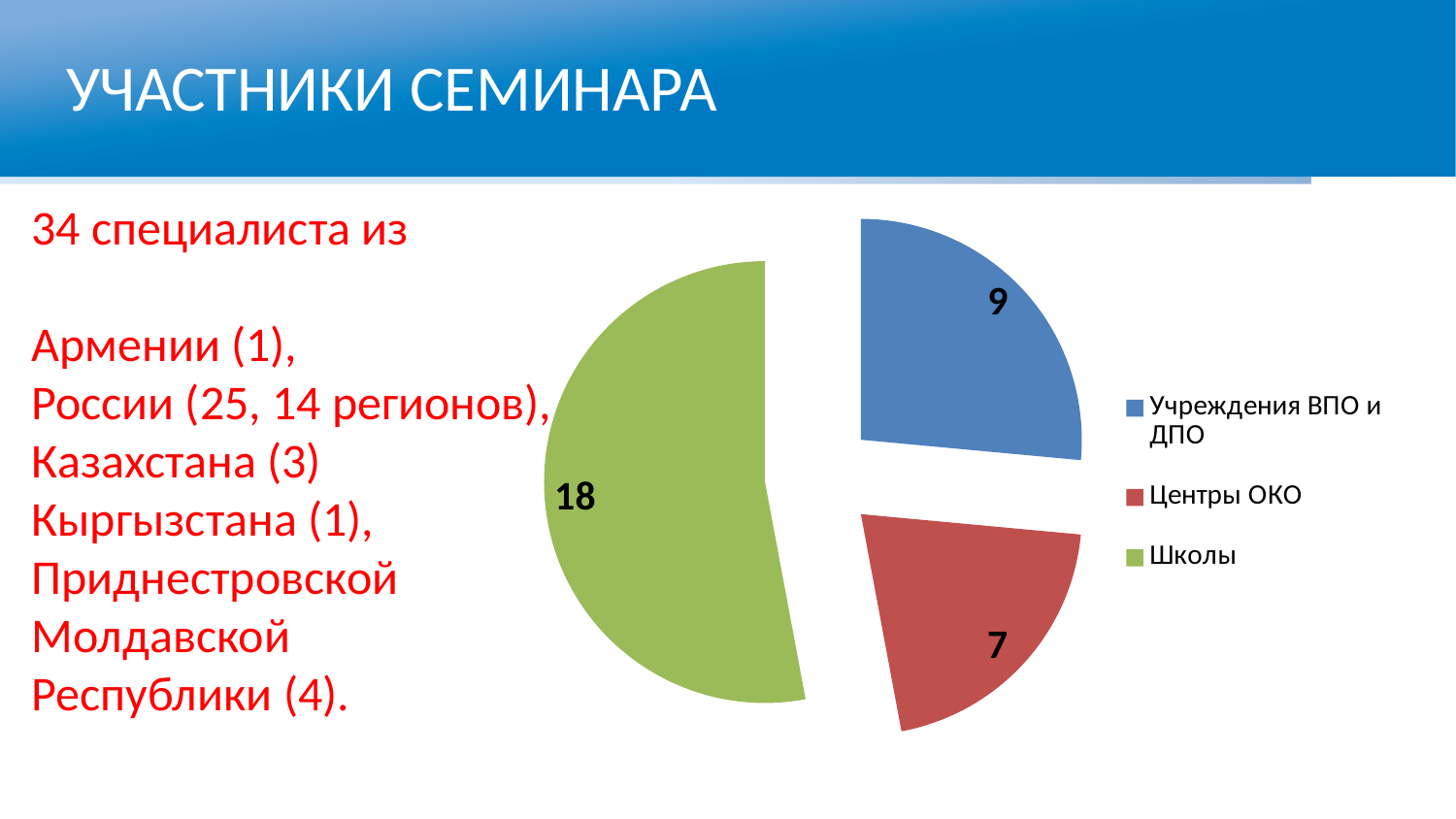
How many entries does the legend of the pie chart list? 3 Which category has the smallest slice in the pie chart? Центры ОКО Which category has the largest slice in the pie chart? Школы Which is larger, the value for Учреждения ВПО и ДПО or the value for Центры ОКО? Учреждения ВПО и ДПО What is the total of all slices in the pie chart? 34 What is the value for Школы in the pie chart? 18 What kind of chart is shown on the slide? pie chart What is the value for Учреждения ВПО и ДПО in the pie chart? 9 What is the difference between the values for Школы and Учреждения ВПО и ДПО? 9 Which colour represents Школы in the pie chart? green How many slices does the pie chart have? 3 What is the value for Центры ОКО in the pie chart? 7